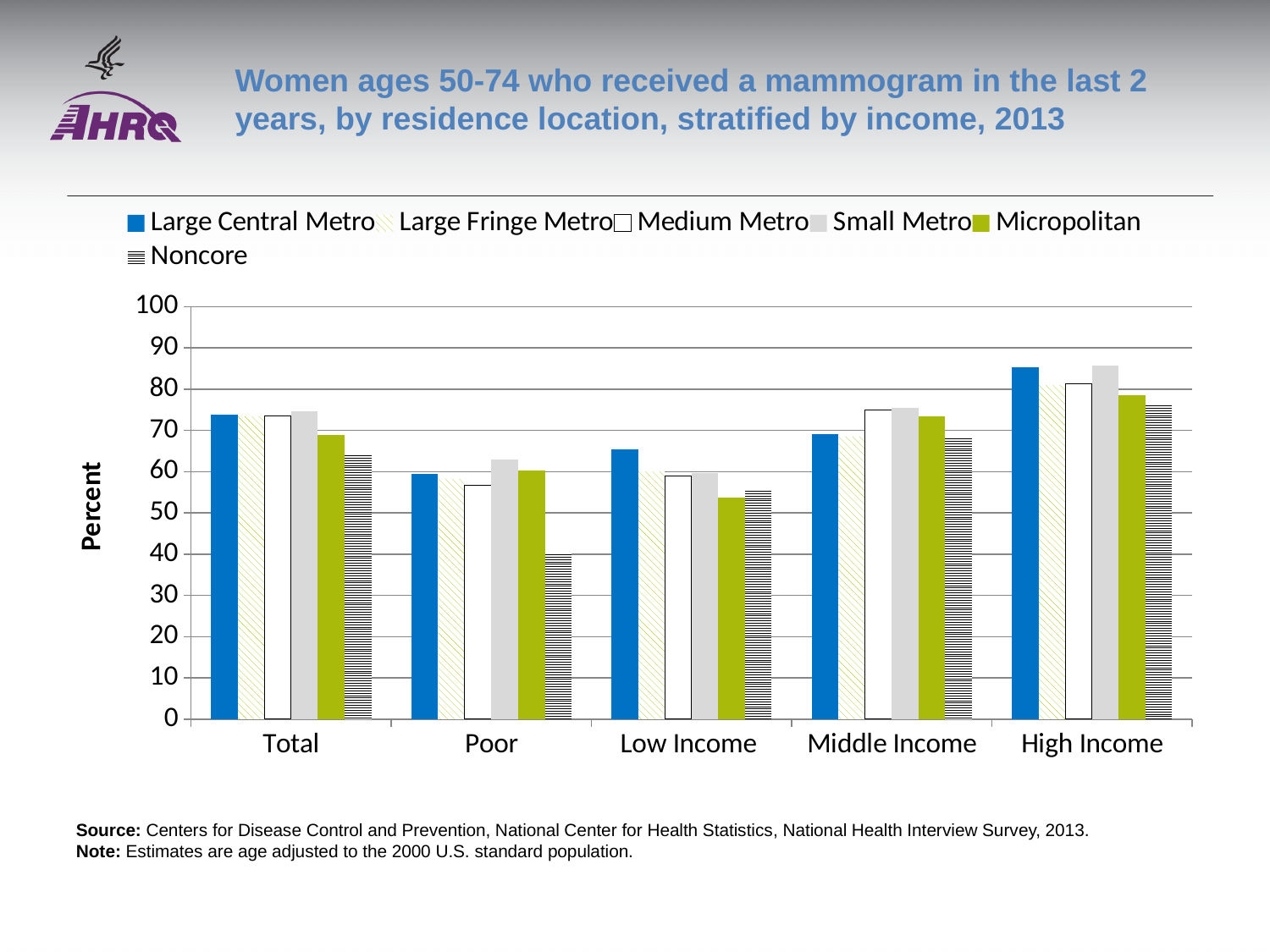
What is the label on the y axis? Percent Is the Noncore value for Poor greater or less than 50? less Which is larger: the Noncore value for Poor or the Noncore value for Low Income? Low Income Which income category has the highest Large Central Metro value? High Income Is the Micropolitan value for Low Income greater or less than 60? less What kind of chart is shown on the slide? bar chart Is the Noncore value for Total greater or less than 60? greater How many categories are shown along the x axis? 5 Within the Poor category, which residence location has the lowest value? Noncore How many series does the legend list? 6 Which category has the lowest Noncore value? Poor